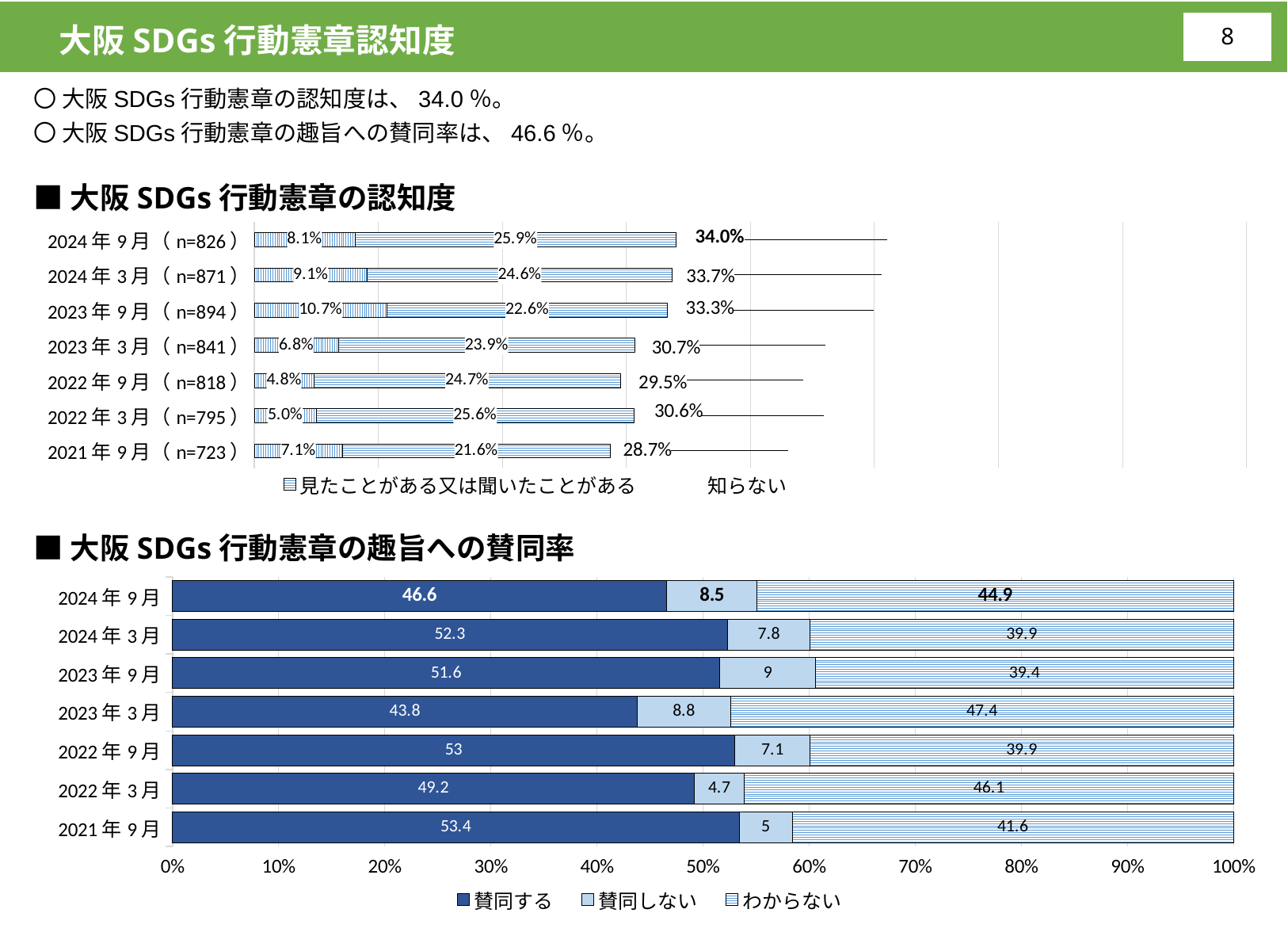
In the 大阪SDGs行動憲章の認知度 chart, what is the difference between the total awareness values for 2024年9月 and 2021年9月? 5.3 percentage points In the 大阪SDGs行動憲章の趣旨への賛同率 chart, what is the わからない value for 2023年3月? 47.4 In the 大阪SDGs行動憲章の趣旨への賛同率 chart, which survey period has the highest 賛同する value? 2021年9月 In the 大阪SDGs行動憲章の趣旨への賛同率 chart, what is the 賛同する value for 2024年9月? 46.6 In the 大阪SDGs行動憲章の認知度 chart, what is the first segment value for 2023年9月 (n=894)? 10.7% In the 大阪SDGs行動憲章の趣旨への賛同率 chart, how many series does the legend list? 3 What type of chart is the 大阪SDGs行動憲章の趣旨への賛同率 chart? Stacked bar chart In the 大阪SDGs行動憲章の認知度 chart, which survey period has the lowest total awareness value? 2021年9月 (n=723) In the 大阪SDGs行動憲章の認知度 chart, how many survey periods are shown? 7 In the 大阪SDGs行動憲章の趣旨への賛同率 chart, which survey period has the lowest 賛同しない value? 2022年3月 In the 大阪SDGs行動憲章の認知度 chart, what is the total awareness value shown for 2024年9月 (n=826)? 34.0% In the 大阪SDGs行動憲章の趣旨への賛同率 chart, is the 賛同する value for 2024年3月 larger or smaller than that for 2023年3月? larger